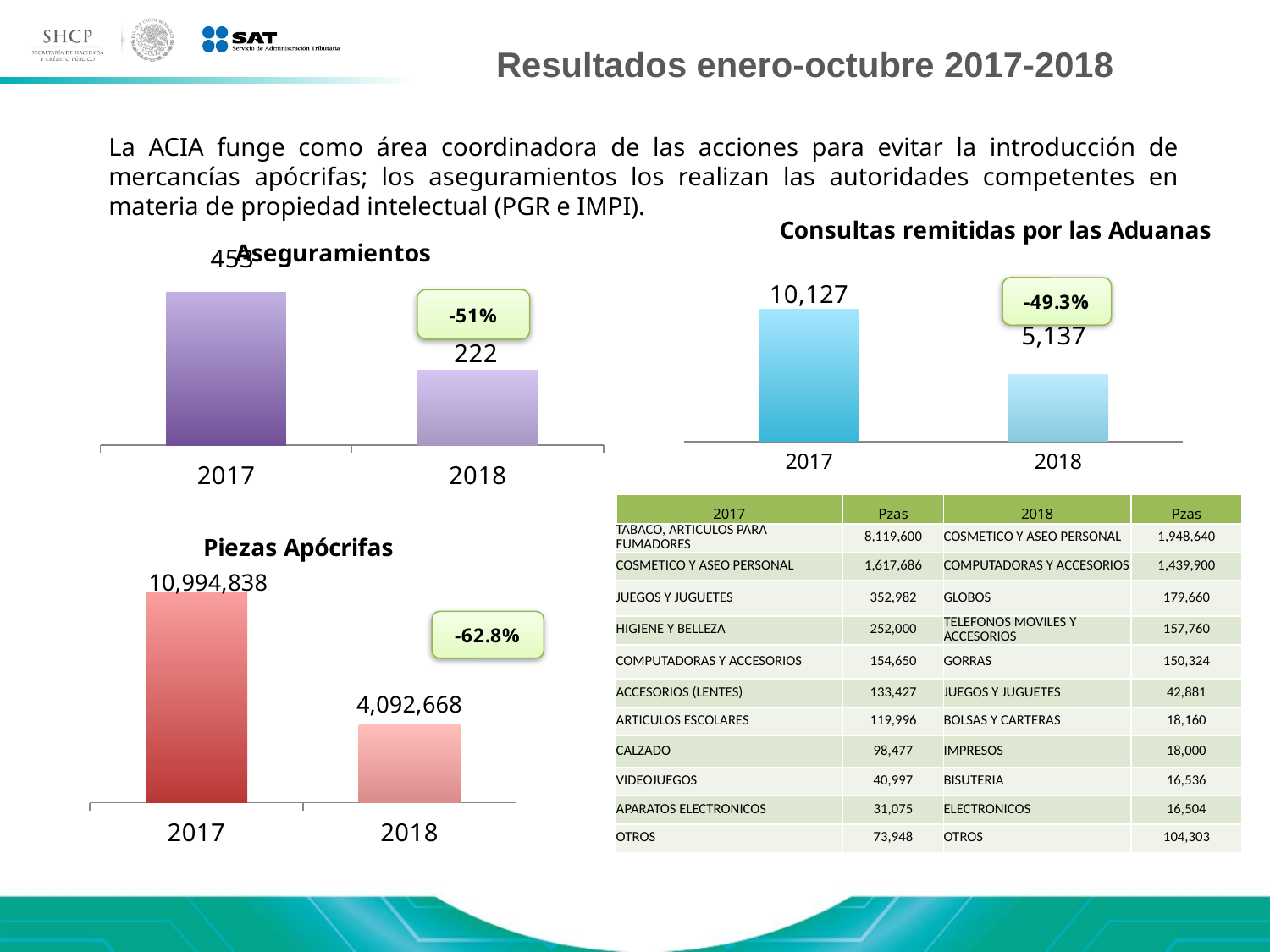
In the 'Aseguramientos' chart, which year has the higher value? 2017 In the 'Piezas Apócrifas' chart, what is the value for 2018? 4,092,668 In the 'Piezas Apócrifas' chart, which year has the lower value? 2018 What kind of chart is the 'Consultas remitidas por las Aduanas' chart? Bar chart In the 'Consultas remitidas por las Aduanas' chart, what is the difference between the 2017 and 2018 values? 4,990 In the 'Aseguramientos' chart, what is the value for 2018? 222 In the 'Consultas remitidas por las Aduanas' chart, what is the value for 2018? 5,137 In the 'Piezas Apócrifas' chart, what is the value for 2017? 10,994,838 How many categories are shown on the x axis of the 'Piezas Apócrifas' chart? 2 In the 'Piezas Apócrifas' chart, what percentage change is shown in the callout box? -62.8% In the 'Aseguramientos' chart, what percentage change is shown in the callout box? -51% In the 'Consultas remitidas por las Aduanas' chart, what is the value for 2017? 10,127